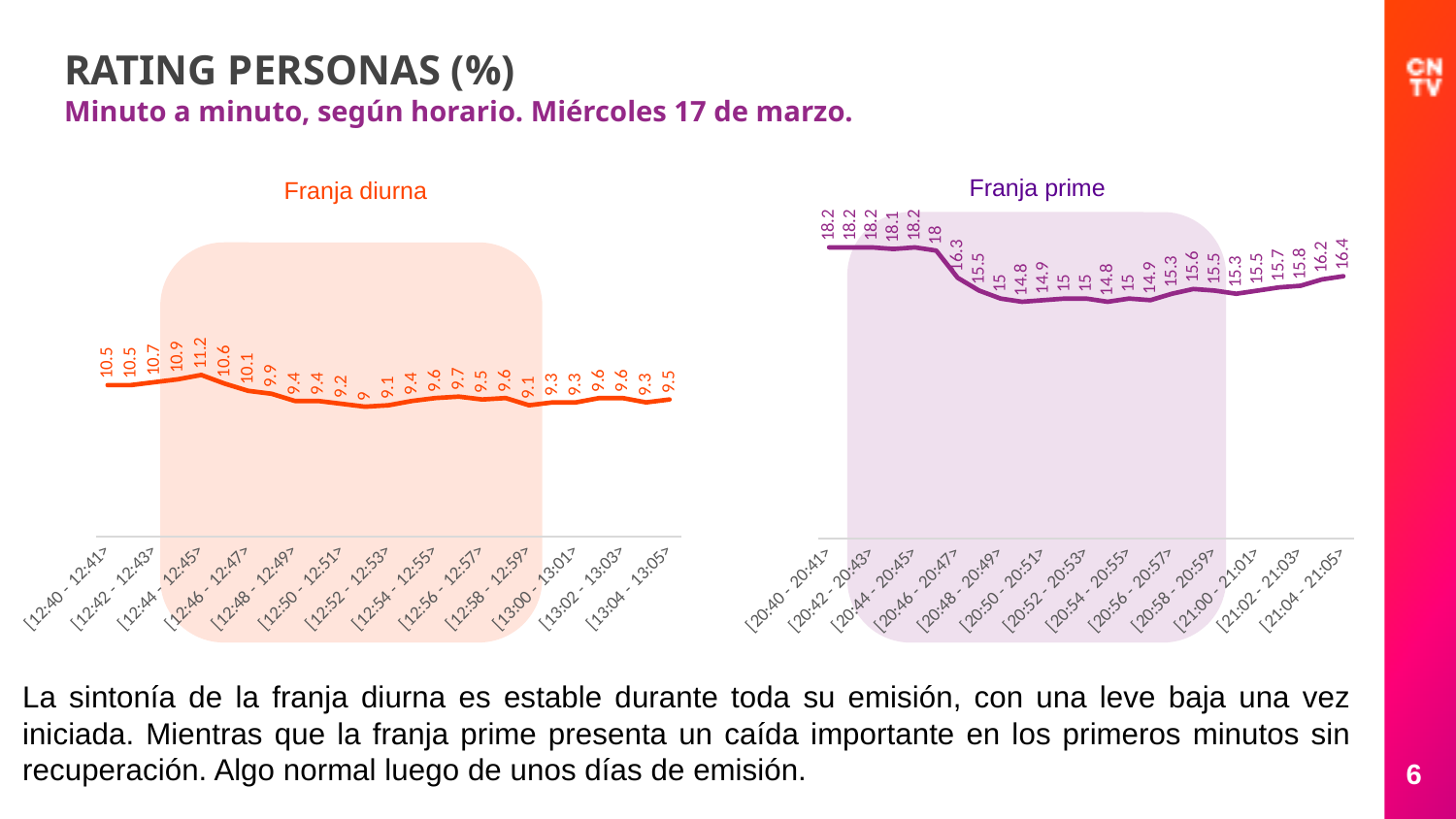
How many data points are plotted in the Franja diurna chart? 25 What kind of chart is used for the Franja diurna data? line chart In the Franja prime chart, what is the highest rating value plotted? 18.2 In the Franja prime chart, do the values overall rise or fall from the first interval to the last? fall What colour is the line in the Franja diurna chart? orange In the Franja prime chart, what is the difference between the first value (18.2) and the last value (16.4)? 1.8 In the Franja diurna chart, what is the highest rating value plotted? 11.2 In the Franja prime chart, what is the rating value for the last interval [21:04 - 21:05>? 16.4 In the Franja diurna chart, what is the rating value for the first interval [12:40 - 12:41>? 10.5 In the Franja diurna chart, what is the lowest rating value plotted? 9 Which is larger: the first value of the Franja prime chart or the first value of the Franja diurna chart? Franja prime In the Franja prime chart, what is the lowest rating value plotted? 14.8